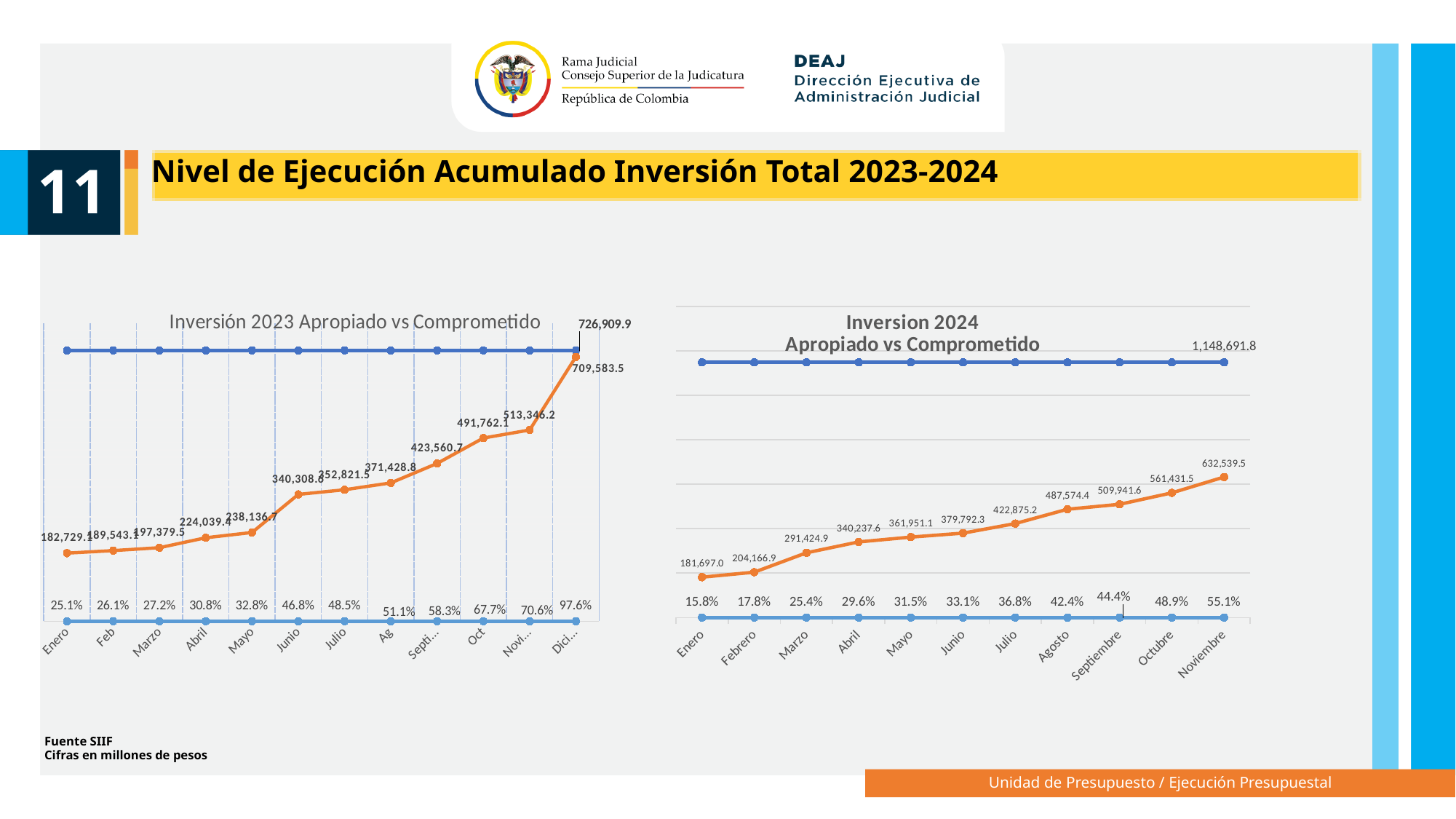
In the 'Inversion 2024 Apropiado vs Comprometido' chart, which month has the lowest committed value on the orange line? Enero How many months are plotted on the x axis of the 'Inversion 2024 Apropiado vs Comprometido' chart? 11 In the 'Inversion 2024 Apropiado vs Comprometido' chart, what is the value of the flat blue appropriated line? 1,148,691.8 In the 'Inversión 2023 Apropiado vs Comprometido' chart, what execution percentage is shown for Diciembre? 97.6% In the 'Inversion 2024 Apropiado vs Comprometido' chart, what is the committed (orange line) value for Noviembre? 632,539.5 In the 'Inversión 2023 Apropiado vs Comprometido' chart, which is larger: the committed value for Octubre or for Septiembre? Octubre In the 'Inversión 2023 Apropiado vs Comprometido' chart, what is the value of the flat blue appropriated line? 726,909.9 In the 'Inversion 2024 Apropiado vs Comprometido' chart, what execution percentage is shown for Julio? 36.8% In the 'Inversion 2024 Apropiado vs Comprometido' chart, what is the committed value for Abril? 340,237.6 What type of chart is 'Inversión 2023 Apropiado vs Comprometido'? Line chart In the 'Inversion 2024 Apropiado vs Comprometido' chart, which month has the highest committed value on the orange line? Noviembre In the 'Inversion 2024 Apropiado vs Comprometido' chart, what is the difference between the committed values for Noviembre and Octubre? 71,108.0